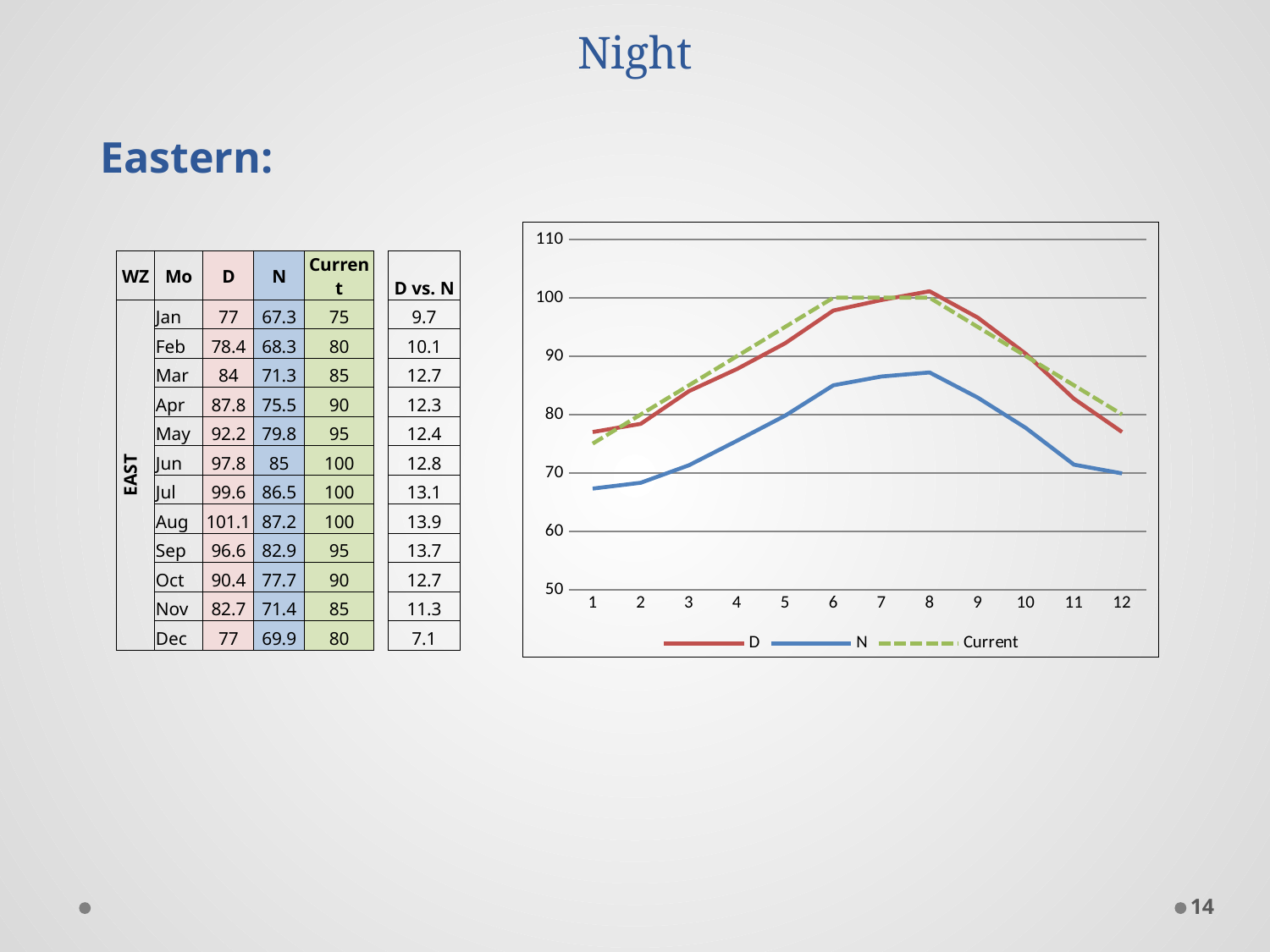
At which x-axis point does the D series reach its highest value? 8 At point 3, which series has the larger value, D or N? D According to the table, what is the difference D vs. N for Aug? 13.9 How many series does the chart legend list? 3 Which series is drawn with a dashed line in the chart? Current According to the table, what is the D value for Aug? 101.1 At which x-axis point is the N series at its lowest value? 1 What kind of chart is shown on the slide? line chart Does the D series rise or fall from point 1 to point 8? rise How many points are plotted along the x axis of the chart? 12 Is the value of the N series at point 6 greater or less than 80? greater Is the value of the D series at point 12 greater or less than 80? less